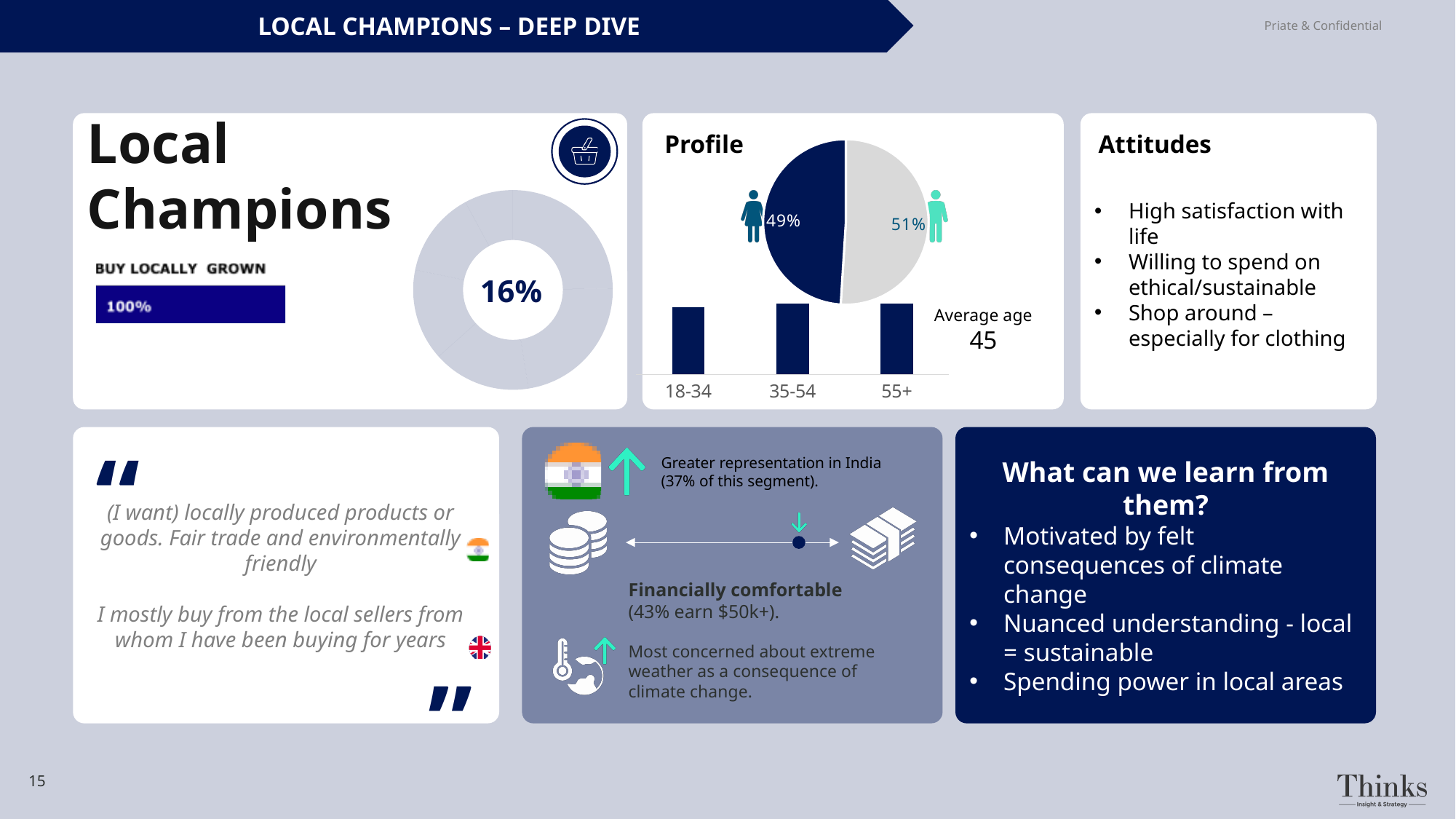
In the Profile pie chart, what percentage is shown for the dark navy slice? 49% What are the category labels on the x axis of the bar chart in the Profile panel? 18-34, 35-54, 55+ In the Profile pie chart, which slice is larger, the dark navy one or the light grey one? light grey How many age categories are shown on the x axis of the bar chart in the Profile panel? 3 What average age is stated next to the bar chart in the Profile panel? 45 What kind of chart is used in the Profile panel to show the 49% and 51% split? pie chart In the Profile pie chart, what is the difference between the two slices' percentages? 2% In the donut chart in the Local Champions panel, what percentage is shown in the centre? 16% What kind of chart shows the age groups in the Profile panel? bar chart In the Profile pie chart, what percentage is shown for the light grey slice? 51% What value is shown on the 'BUY LOCALLY GROWN' bar in the Local Champions panel? 100%